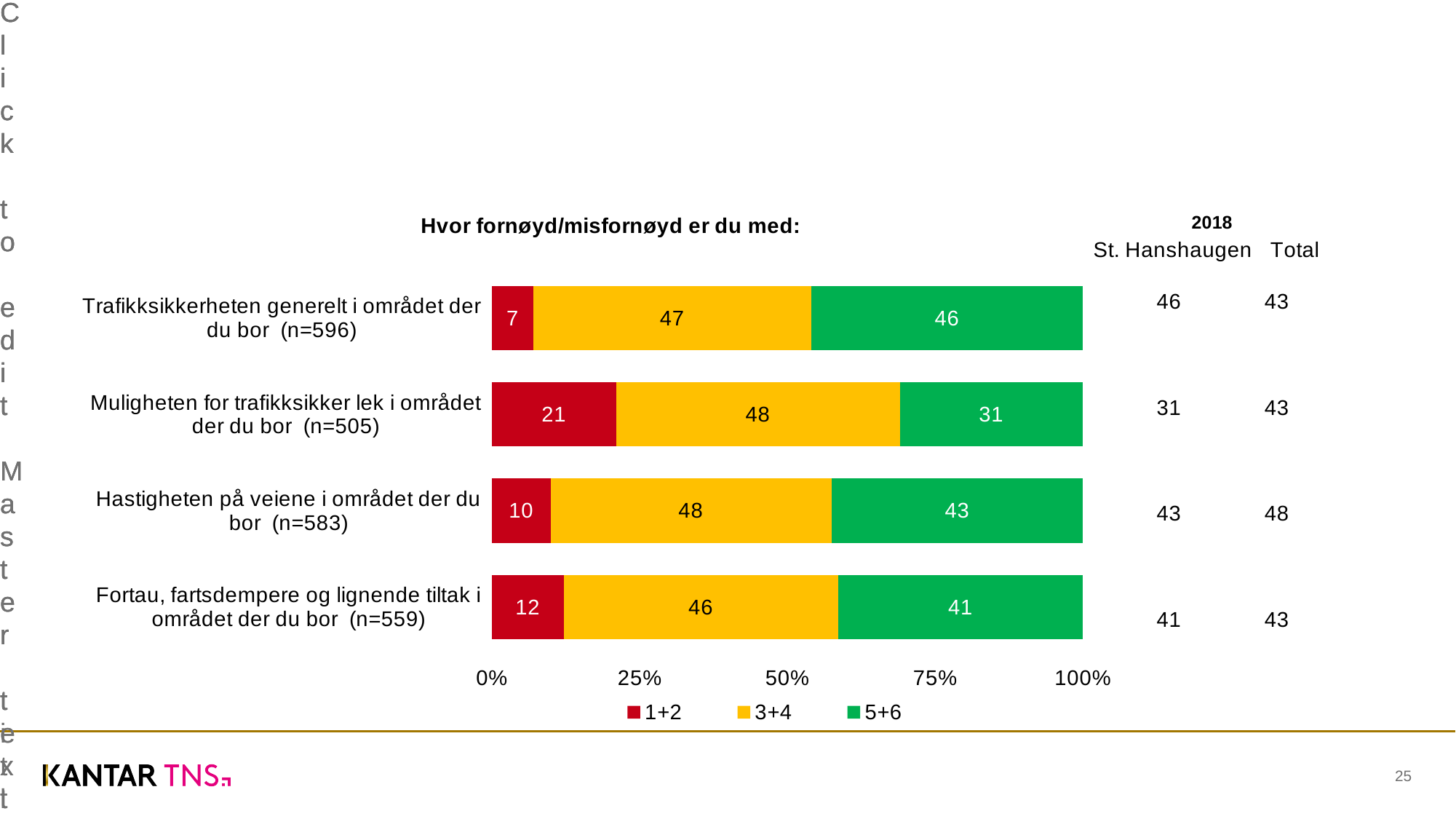
What is the title of the chart? Hvor fornøyd/misfornøyd er du med: Which is larger: the 1+2 value for 'Fortau, fartsdempere og lignende tiltak i området der du bor' or for 'Hastigheten på veiene i området der du bor'? Fortau, fartsdempere og lignende tiltak i området der du bor Which category has the highest 1+2 value? Muligheten for trafikksikker lek i området der du bor What is the value of the 3+4 segment for 'Hastigheten på veiene i området der du bor'? 48 Which category has the lowest 5+6 value? Muligheten for trafikksikker lek i området der du bor What is the value of the 5+6 segment for 'Trafikksikkerheten generelt i området der du bor'? 46 What is the value of the 1+2 segment for 'Muligheten for trafikksikker lek i området der du bor'? 21 How many categories are plotted in the chart? 4 What type of chart is shown on the slide? stacked bar chart How many series does the legend list? 3 What is the total of the stacked bar for 'Muligheten for trafikksikker lek i området der du bor'? 100 What is the difference between the 5+6 values for 'Trafikksikkerheten generelt i området der du bor' and 'Muligheten for trafikksikker lek i området der du bor'? 15